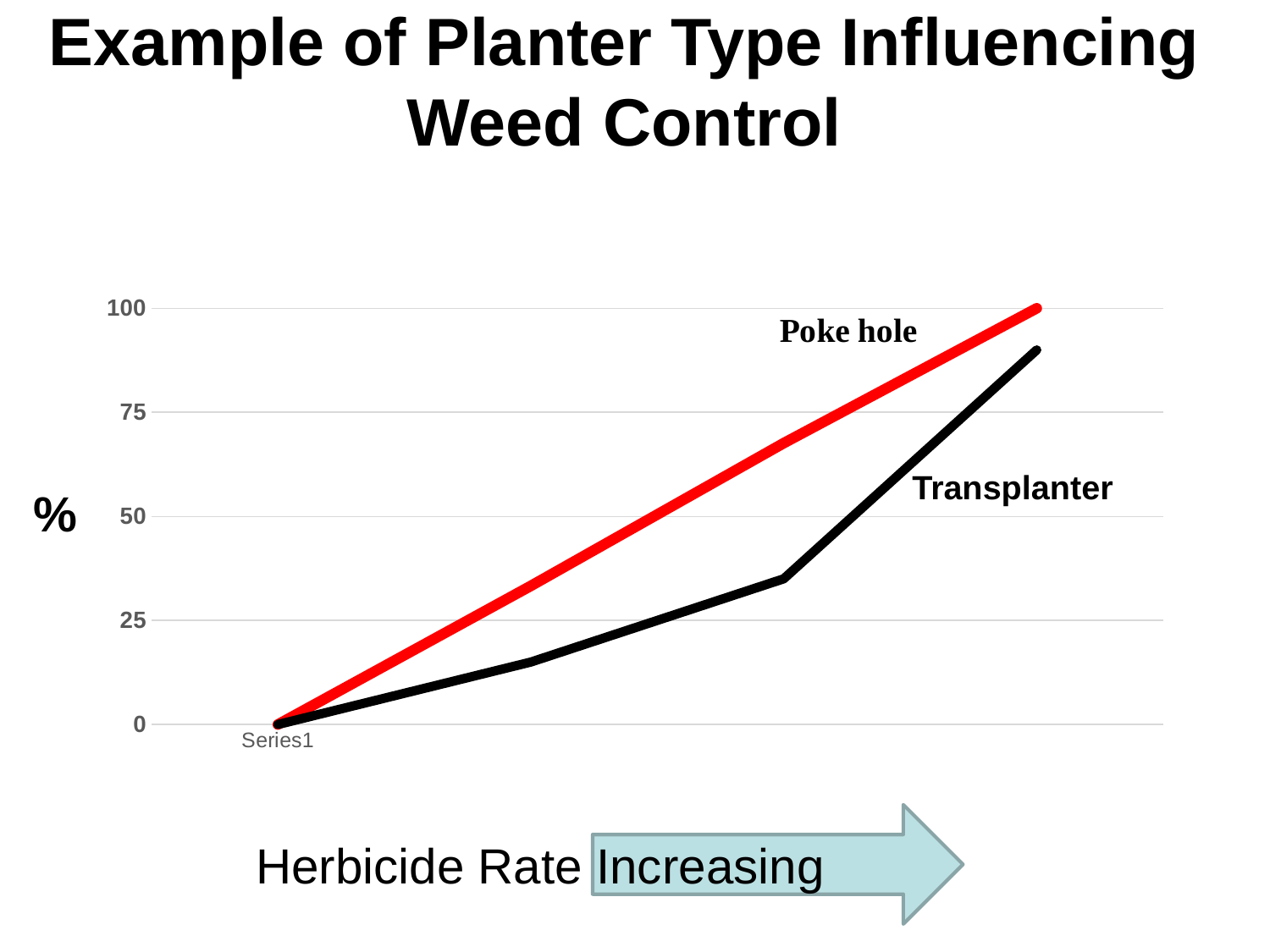
What is the highest value shown on the y axis? 100 What kind of chart is shown on the slide? line chart What are the names of the two lines plotted on the chart? Poke hole and Transplanter Do the values for Transplanter rise or fall as herbicide rate increases along the x axis? rise Is the final value for Transplanter greater or less than 75? greater Is the middle point of the Transplanter line greater or less than 50? less How many lines are plotted on the chart? 2 Which line reaches the higher value at the right end of the chart, Poke hole or Transplanter? Poke hole What colour is the Poke hole line? red Do the values for Poke hole rise or fall along the x axis? rise What value does the Poke hole line reach at the right end of the chart? 100 What value do both lines start at on the left of the chart? 0